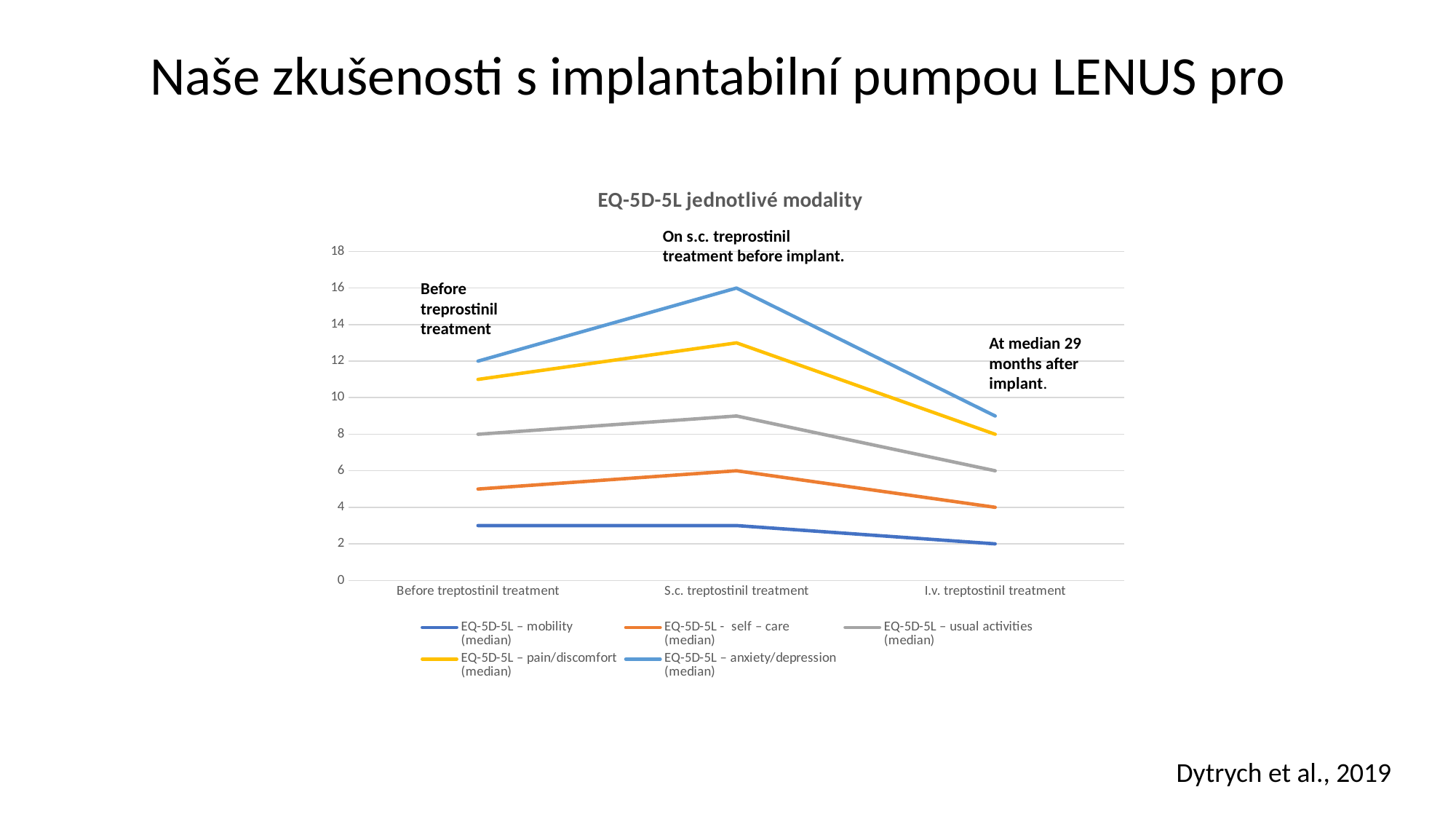
What is the value of EQ-5D-5L – mobility (median) at I.v. treptostinil treatment? 2 How many categories are shown on the x axis? 3 What is the title of the chart? EQ-5D-5L jednotlivé modality What kind of chart is shown on the slide? line chart How many series does the legend list? 5